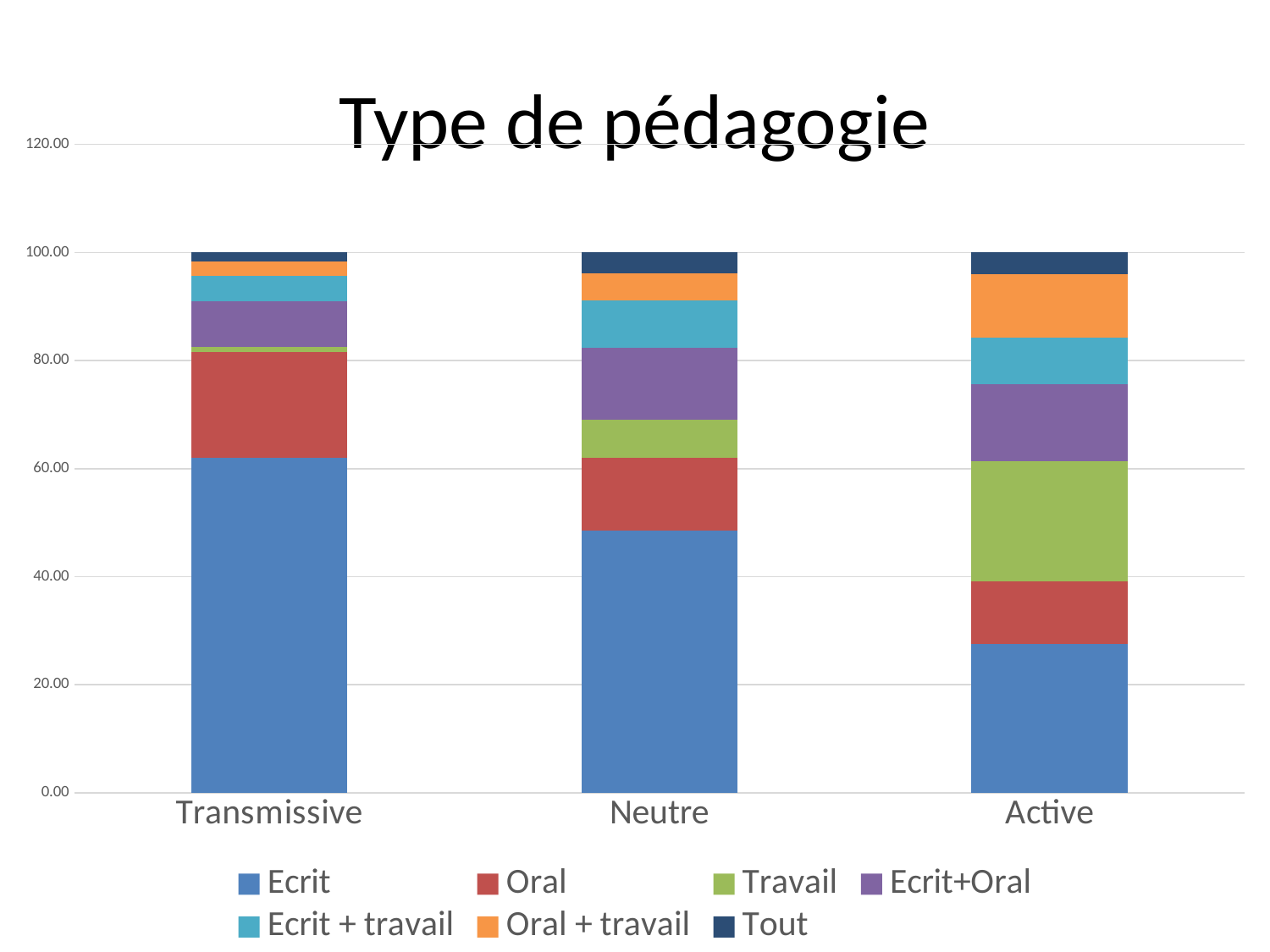
What is the title of the chart? Type de pédagogie Which colour represents the Ecrit series in the legend? blue Which category has the smallest Ecrit segment? Active Which category has the largest Ecrit segment? Transmissive How many series does the legend list? 7 Is the Ecrit value for Transmissive greater or less than 40.00? greater Is the Ecrit value for Active greater or less than 40.00? less Which category has the largest Travail segment? Active How many categories are shown on the x axis? 3 What is the total height of the stacked bar for Transmissive? 100.00 Is the Ecrit segment larger for Neutre or for Active? Neutre What kind of chart is shown on the slide? stacked bar chart